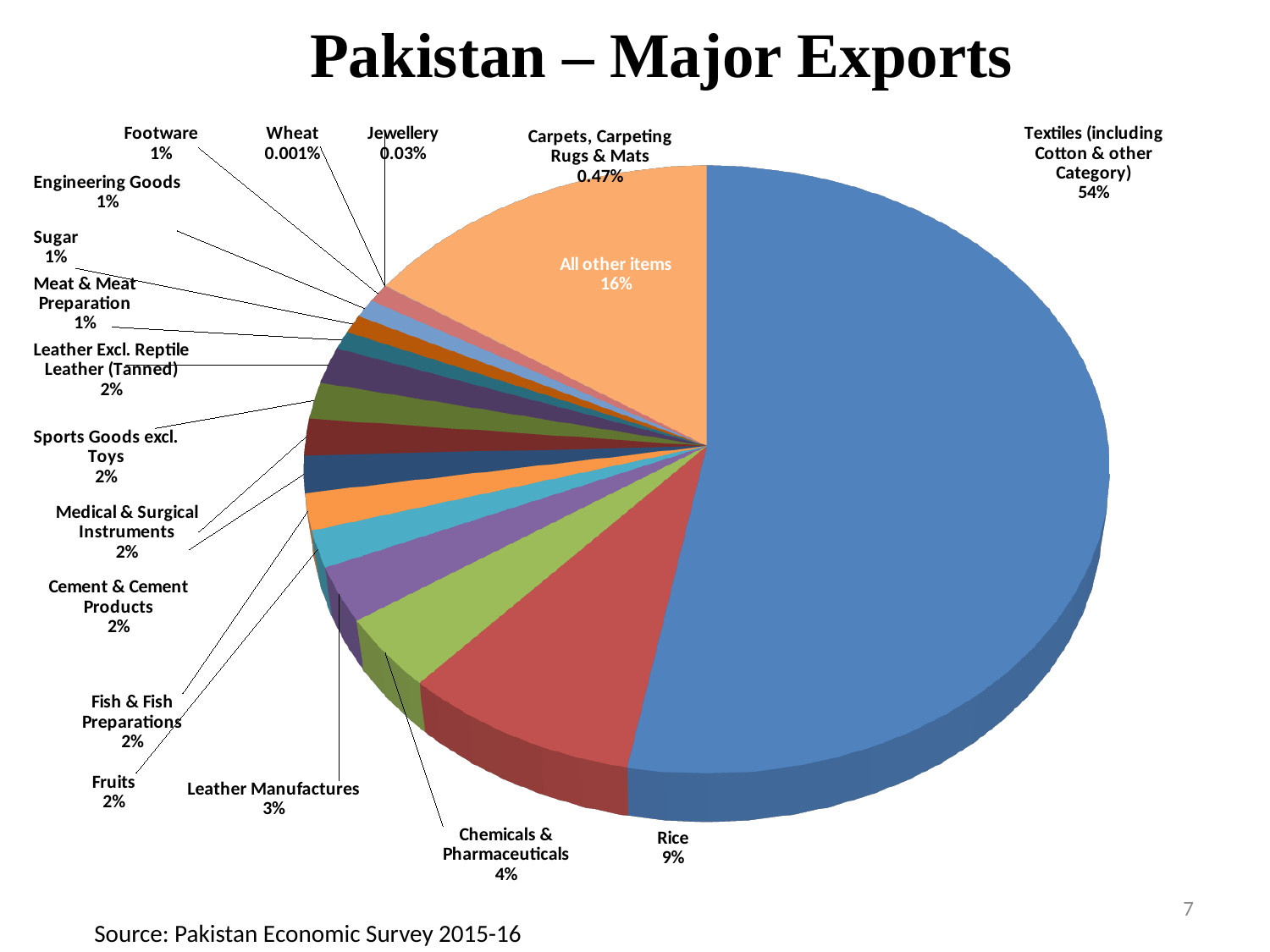
What is the title of the chart? Pakistan – Major Exports Which export category has the smallest share? Wheat Which export category has the largest share? Textiles (including Cotton & other Category) What share of exports is Chemicals & Pharmaceuticals? 4% Which has a larger share, Rice or Chemicals & Pharmaceuticals? Rice What share of exports is Leather Manufactures? 3% What share of exports is Wheat? 0.001% What share of exports is Textiles (including Cotton & other Category)? 54% What is the difference in share between Textiles and All other items? 38% What share of exports is Rice? 9% What share of exports is Carpets, Carpeting Rugs & Mats? 0.47% What kind of chart is shown on the slide? pie chart